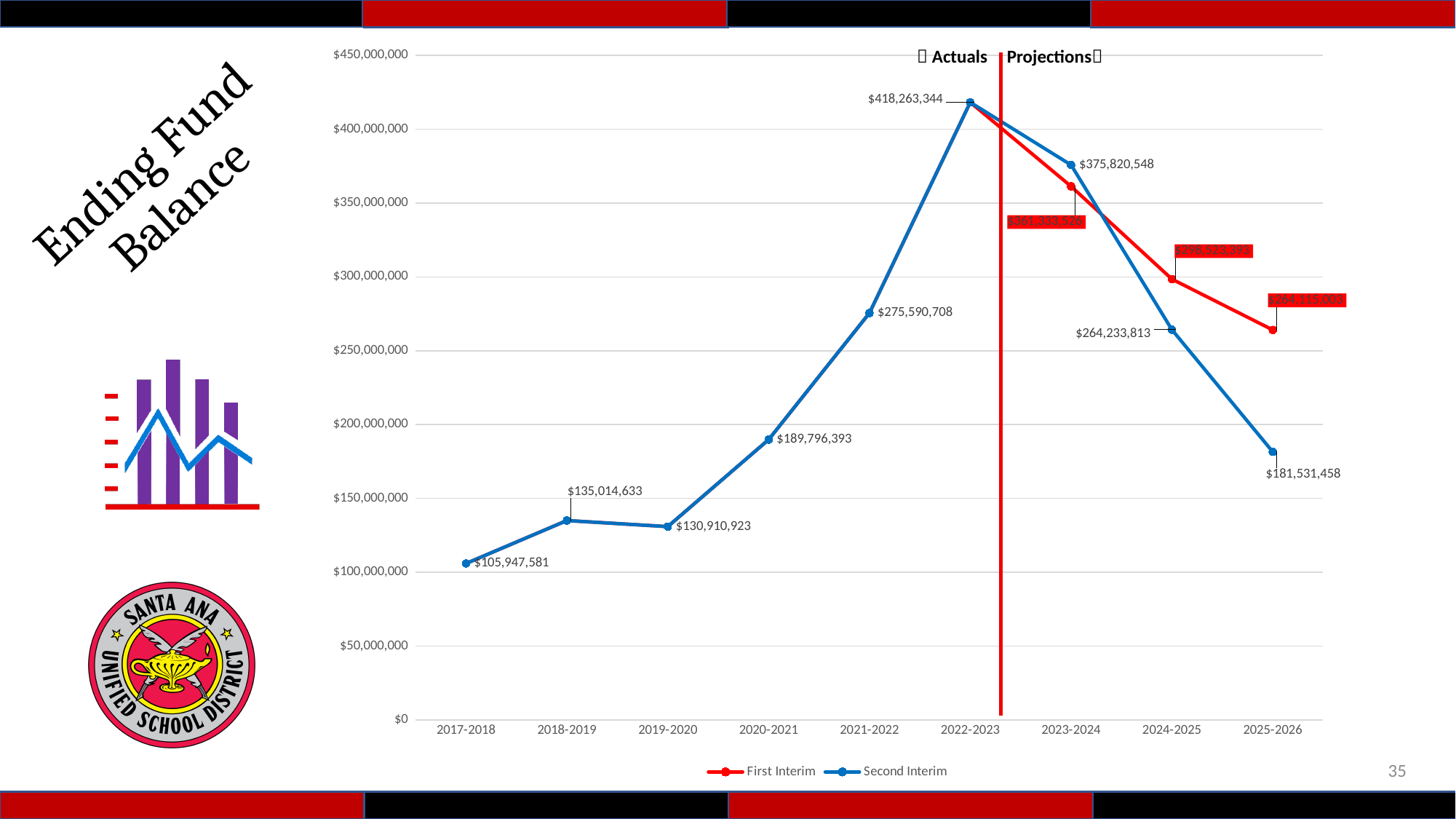
How many fiscal years are shown on the x axis? 9 Does the Second Interim series rise or fall from 2022-2023 to 2025-2026? fall In which year is the Second Interim series at its lowest value? 2017-2018 Which is larger for 2025-2026, the First Interim value or the Second Interim value? First Interim What is the Second Interim ending fund balance for 2025-2026? $181,531,458 How many series does the legend list? 2 In which year does the Second Interim series reach its highest value? 2022-2023 What is the difference between the Second Interim values for 2022-2023 and 2023-2024? $42,442,796 What is the Second Interim ending fund balance for 2022-2023? $418,263,344 Is the First Interim value for 2024-2025 greater or less than $250,000,000? greater What is the Second Interim ending fund balance for 2017-2018? $105,947,581 What kind of chart is shown on the slide? line chart